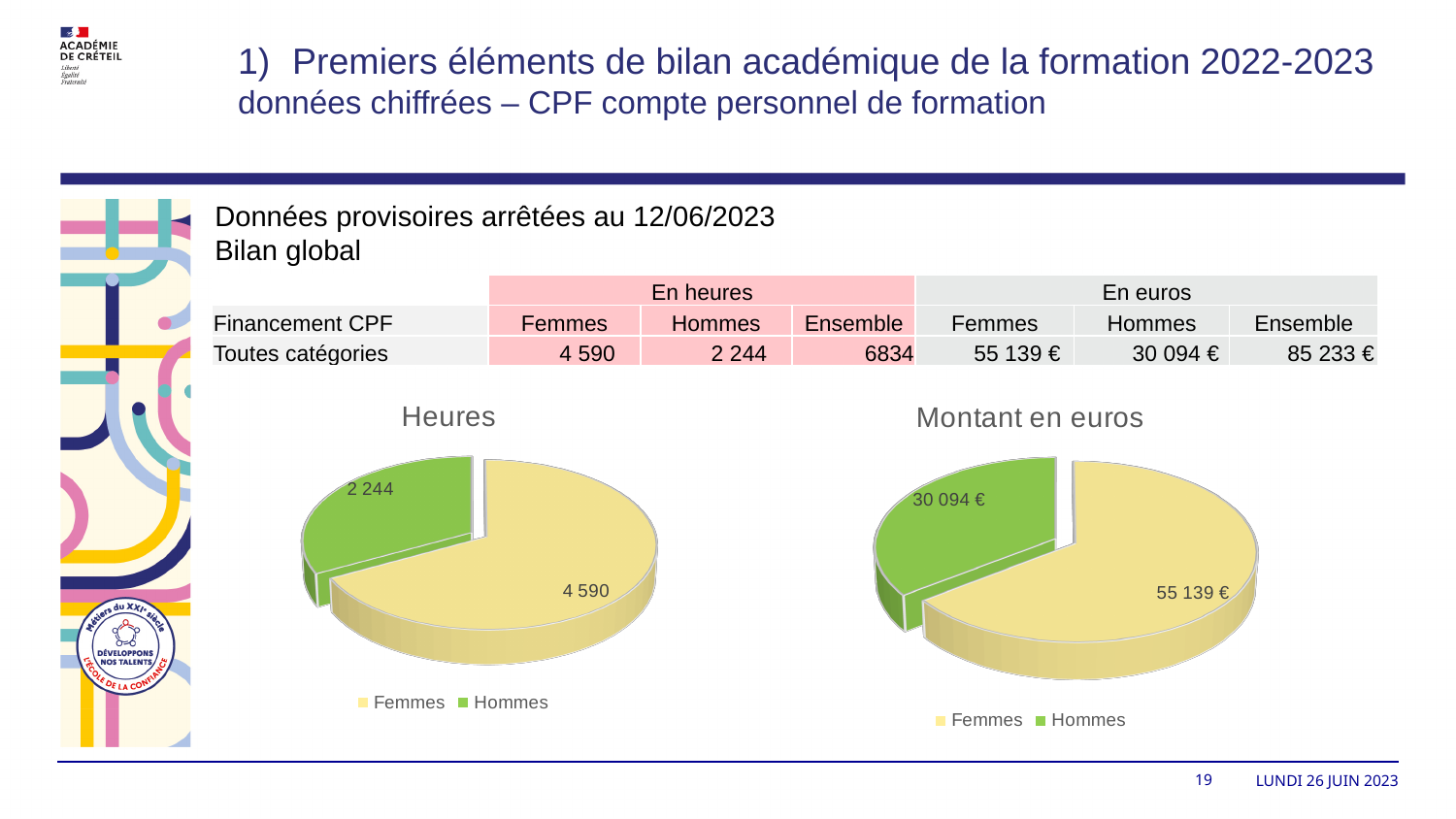
What are the two legend entries of the "Heures" pie chart? Femmes and Hommes In the "Montant en euros" pie chart, what is the difference between the Femmes and Hommes values? 25 045 € In the "Heures" pie chart, what is the difference between the Femmes and Hommes values? 2 346 In the "Heures" pie chart, what is the value for Hommes? 2 244 How many slices does the "Heures" pie chart have? 2 What kind of chart is the "Montant en euros" chart? Pie chart In the "Montant en euros" pie chart, what is the value for Hommes? 30 094 € In the "Montant en euros" pie chart, which category has the smallest slice? Hommes In the "Montant en euros" pie chart, which is larger, the value for Femmes or for Hommes? Femmes In the "Heures" pie chart, what is the value for Femmes? 4 590 In the "Montant en euros" pie chart, what is the value for Femmes? 55 139 € In the "Heures" pie chart, which category has the largest slice? Femmes